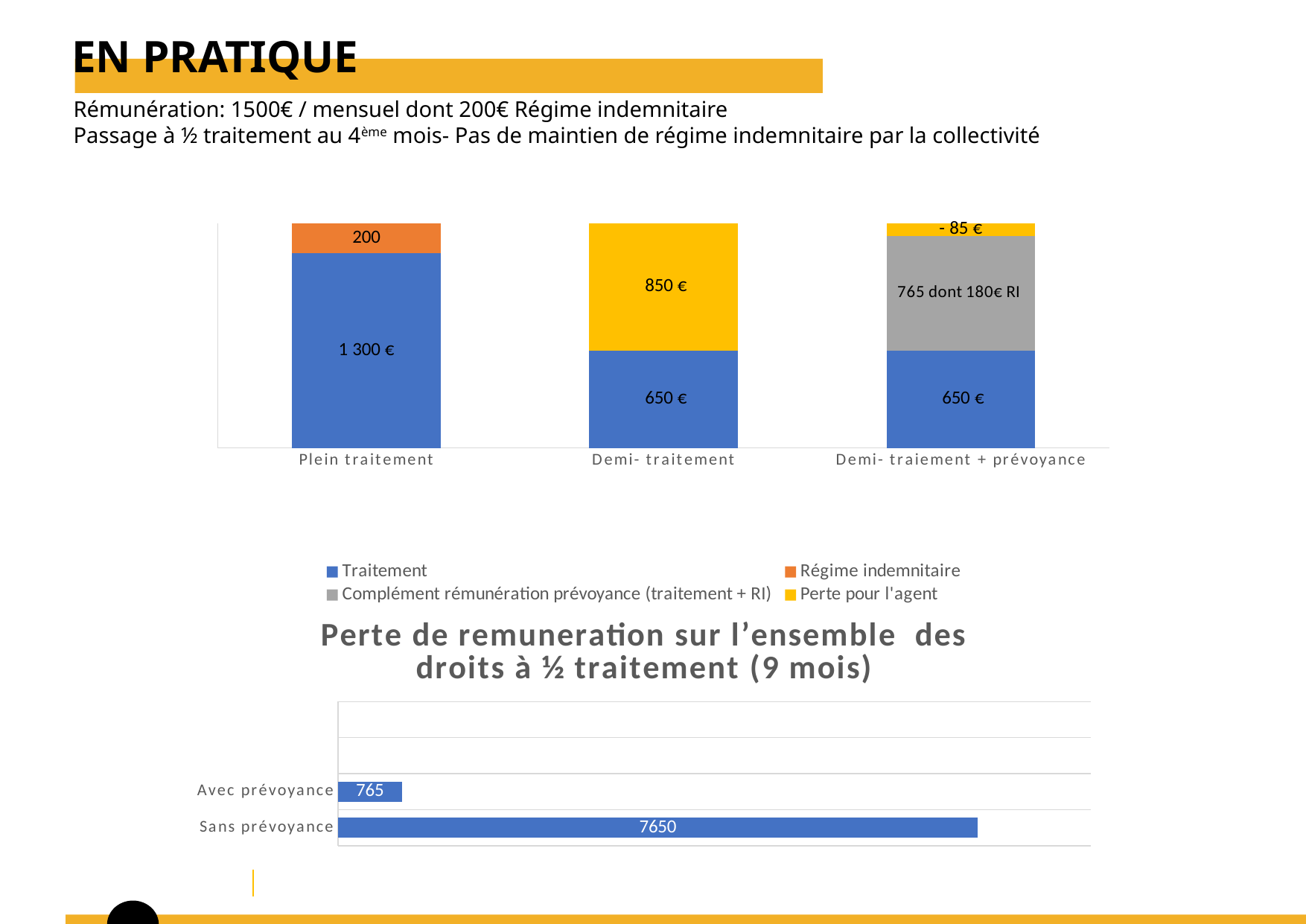
In the top stacked bar chart, what is the Traitement value for Plein traitement? 1 300 € In the top stacked bar chart, what label is shown on the grey Complément rémunération prévoyance segment for Demi- traiement + prévoyance? 765 dont 180€ RI In the top stacked bar chart, how many categories are shown on the x axis? 3 What kind of chart is the one titled 'Perte de remuneration sur l'ensemble des droits à ½ traitement (9 mois)'? Bar chart In the chart titled 'Perte de remuneration sur l'ensemble des droits à ½ traitement (9 mois)', what is the difference between Sans prévoyance and Avec prévoyance? 6885 In the top stacked bar chart, what is the Traitement value for Demi- traitement? 650 € In the top stacked bar chart, how many series does the legend list? 4 In the chart titled 'Perte de remuneration sur l'ensemble des droits à ½ traitement (9 mois)', what is the value for Sans prévoyance? 7650 In the top stacked bar chart, what is the Perte pour l'agent value for Demi- traitement? 850 € In the chart titled 'Perte de remuneration sur l'ensemble des droits à ½ traitement (9 mois)', what is the value for Avec prévoyance? 765 In the top stacked bar chart, what is the Perte pour l'agent value for Demi- traiement + prévoyance? - 85 € In the top stacked bar chart, what is the Régime indemnitaire value for Plein traitement? 200